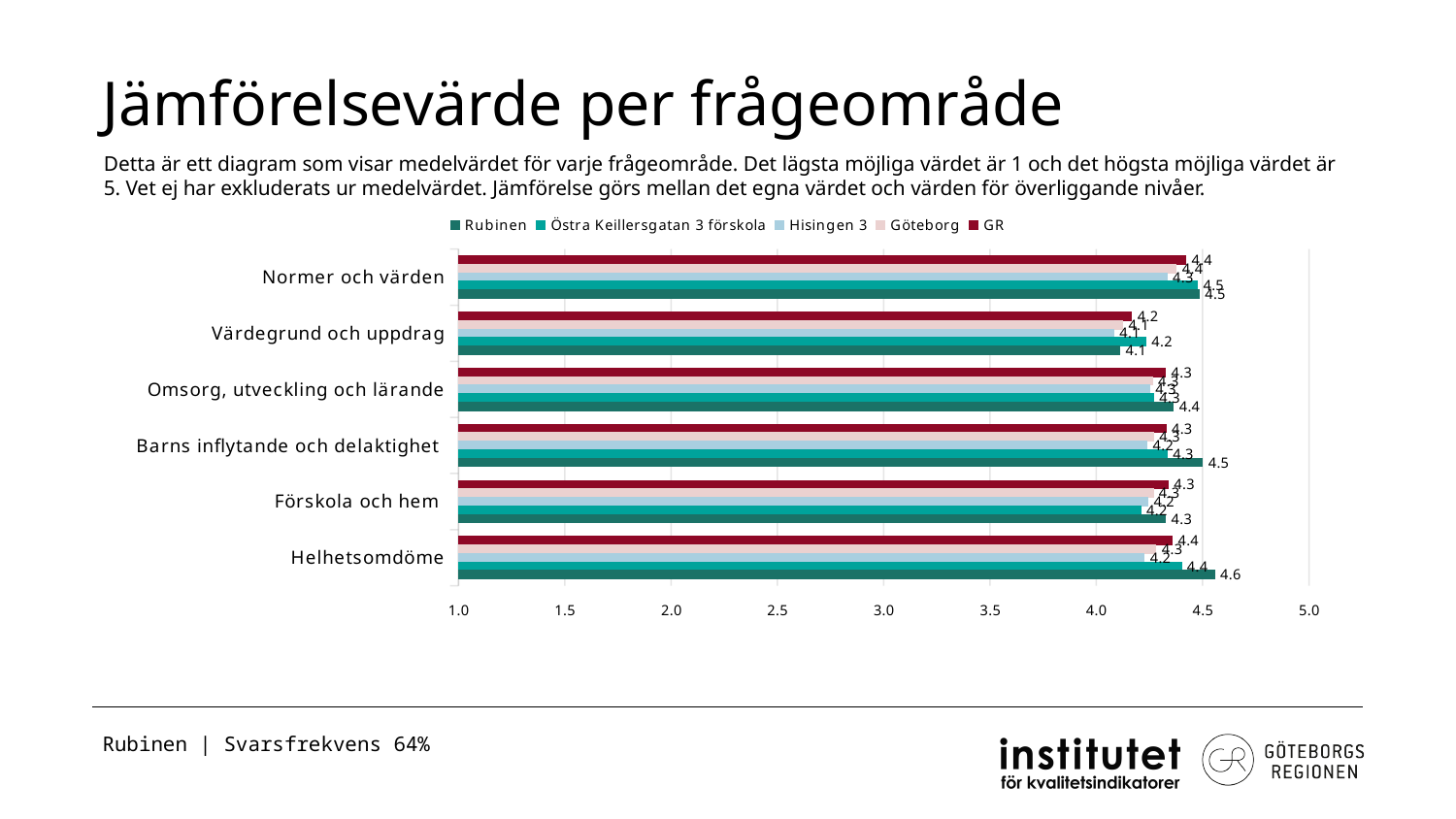
In the Helhetsomdöme category, which is larger: the value for Rubinen or the value for GR? Rubinen How many series does the legend list? 5 What kind of chart is shown on the slide? Bar chart What is the value for Rubinen in the Normer och värden category? 4.5 What is the first series listed in the chart legend? Rubinen What is the value for Rubinen in the Värdegrund och uppdrag category? 4.1 What is the difference between Rubinen's value for Helhetsomdöme and its value for Värdegrund och uppdrag? 0.5 In which category does Rubinen have its highest value? Helhetsomdöme Is the value for Rubinen in Helhetsomdöme greater or less than 4.5? greater How many categories (frågeområden) are shown on the chart? 6 What is the value for Rubinen in the Helhetsomdöme category? 4.6 In which category does Rubinen have its lowest value? Värdegrund och uppdrag